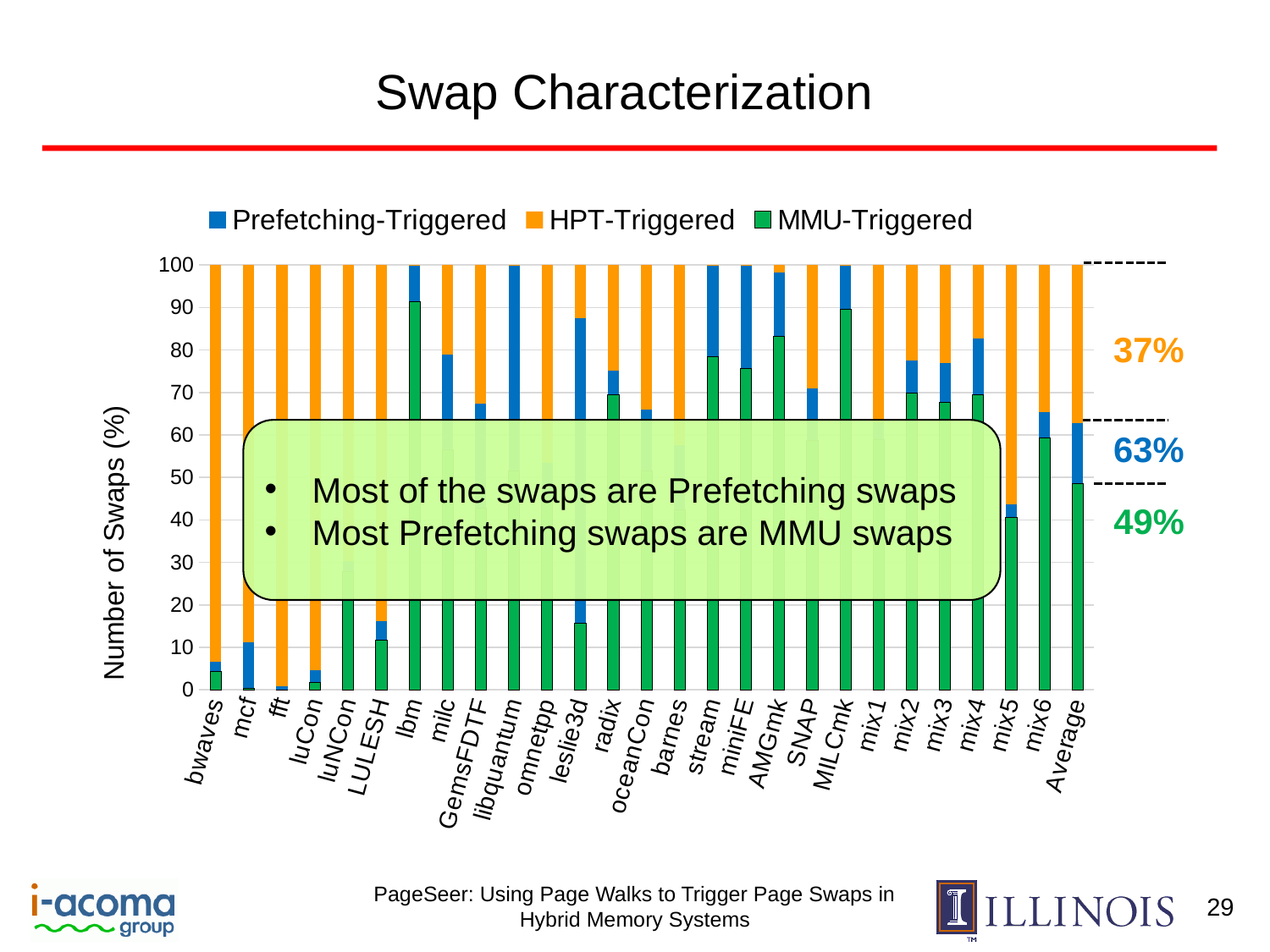
What kind of chart is shown on the slide? bar chart Is the MMU-Triggered value for mix5 greater or less than 50? less What is the label of the y axis? Number of Swaps (%) Is the MMU-Triggered value for bwaves greater or less than 10? less Is the MMU-Triggered value for MILCmk greater or less than 80? greater How many series does the legend list? 3 What is the title of the chart? Swap Characterization How many categories are shown along the x axis? 27 Which is larger, the HPT-Triggered value for fft or for mix6? fft Which category has the highest HPT-Triggered value? fft Which is larger, the MMU-Triggered value for lbm or for mix5? lbm